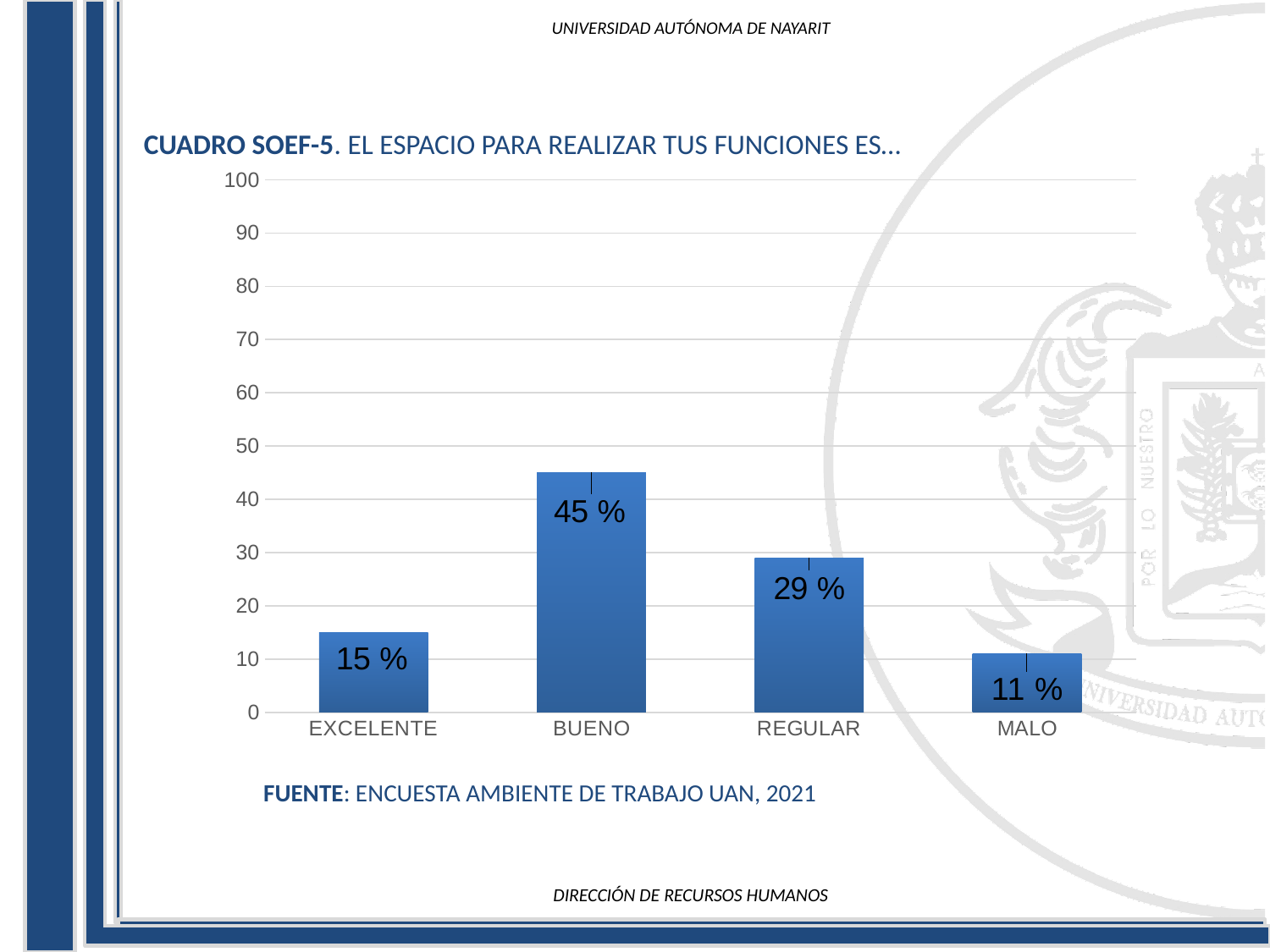
Which category has the lowest value? MALO Which category has the highest value? BUENO How many categories are shown on the x axis? 4 What is the source cited below the chart? ENCUESTA AMBIENTE DE TRABAJO UAN, 2021 What is the value for BUENO? 45 % What kind of chart is shown on the slide? bar chart Is the value for REGULAR greater or less than 20? greater What is the difference between the values for BUENO and REGULAR? 16 % What is the highest value shown on the y axis? 100 What is the value for MALO? 11 % Which is larger, the value for EXCELENTE or the value for REGULAR? REGULAR What is the value for EXCELENTE? 15 %